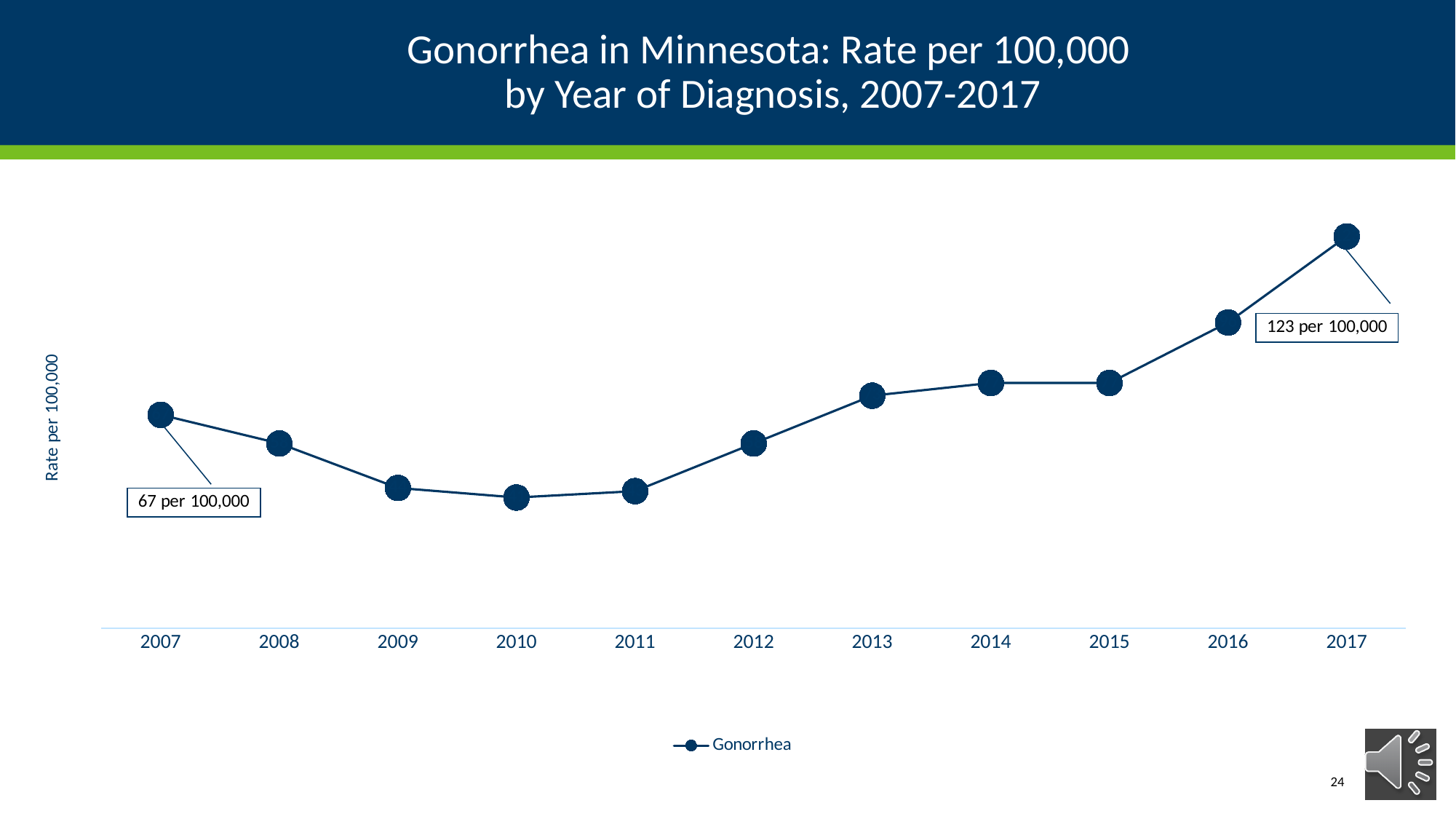
Does the gonorrhea rate rise or fall from 2011 to 2017? Rise What is the gonorrhea rate for 2007? 67 per 100,000 What is the gonorrhea rate for 2017? 123 per 100,000 By how much did the rate per 100,000 increase from 2007 to 2017? 56 What is the label on the vertical axis? Rate per 100,000 What kind of chart is shown on the slide? Line chart Which year has the highest gonorrhea rate? 2017 How many series does the legend list? 1 How many years are plotted on the chart? 11 Does the gonorrhea rate rise or fall from 2007 to 2010? Fall Which year has the higher rate, 2013 or 2016? 2016